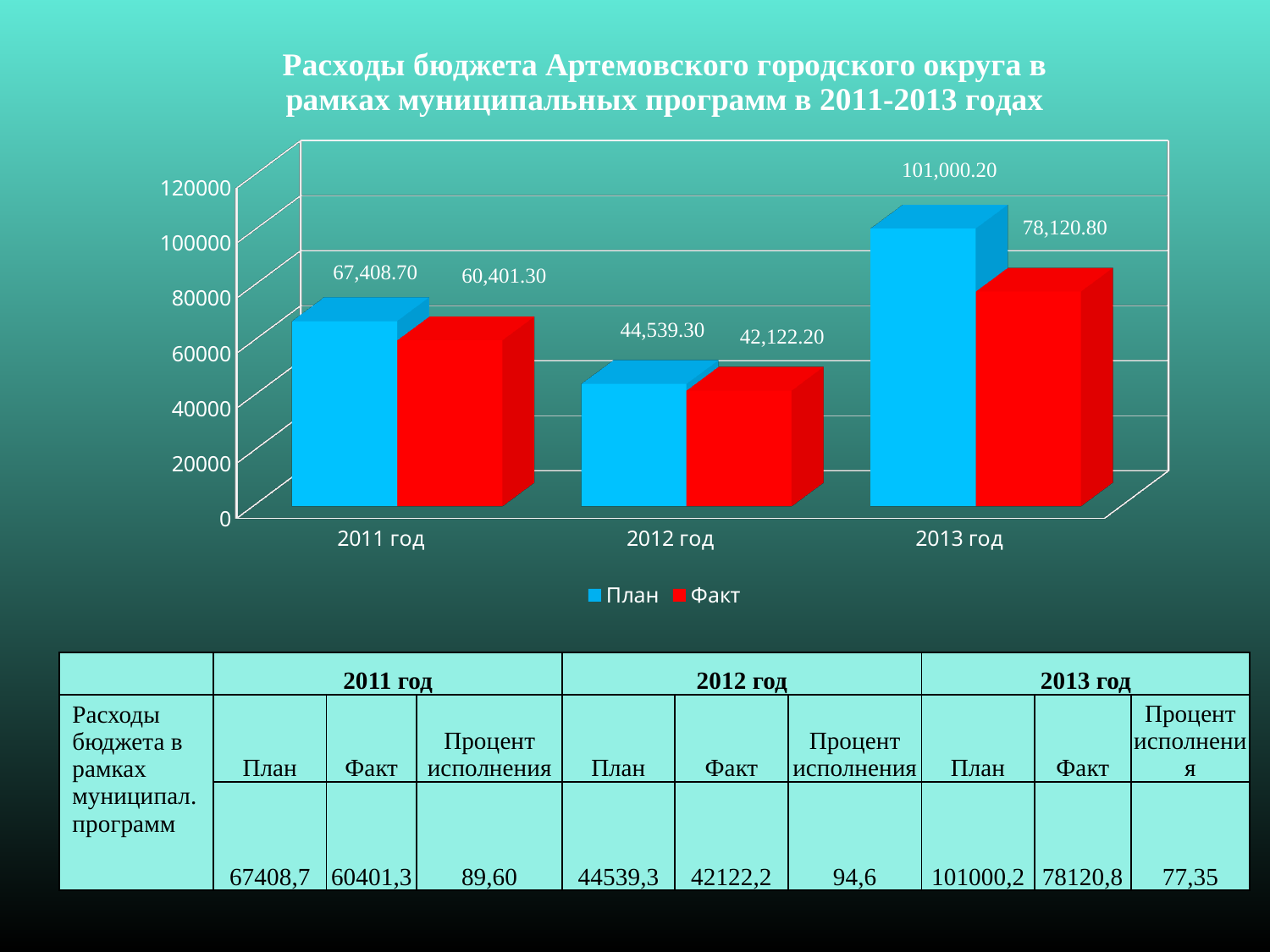
How many years are shown on the x axis? 3 In which year is the План value highest? 2013 год Is the Факт value for 2013 год greater or less than 80000? less What kind of chart is shown on the slide? bar chart What is the difference between План and Факт for 2011 год? 7,007.40 What is the value of Факт for 2012 год? 42,122.20 How many series does the legend list? 2 What is the value of Факт for 2013 год? 78,120.80 What is the difference between План and Факт for 2013 год? 22,879.40 Which is larger for 2012 год, План or Факт? План What is the value of План for 2011 год? 67,408.70 In which year is the Факт value lowest? 2012 год